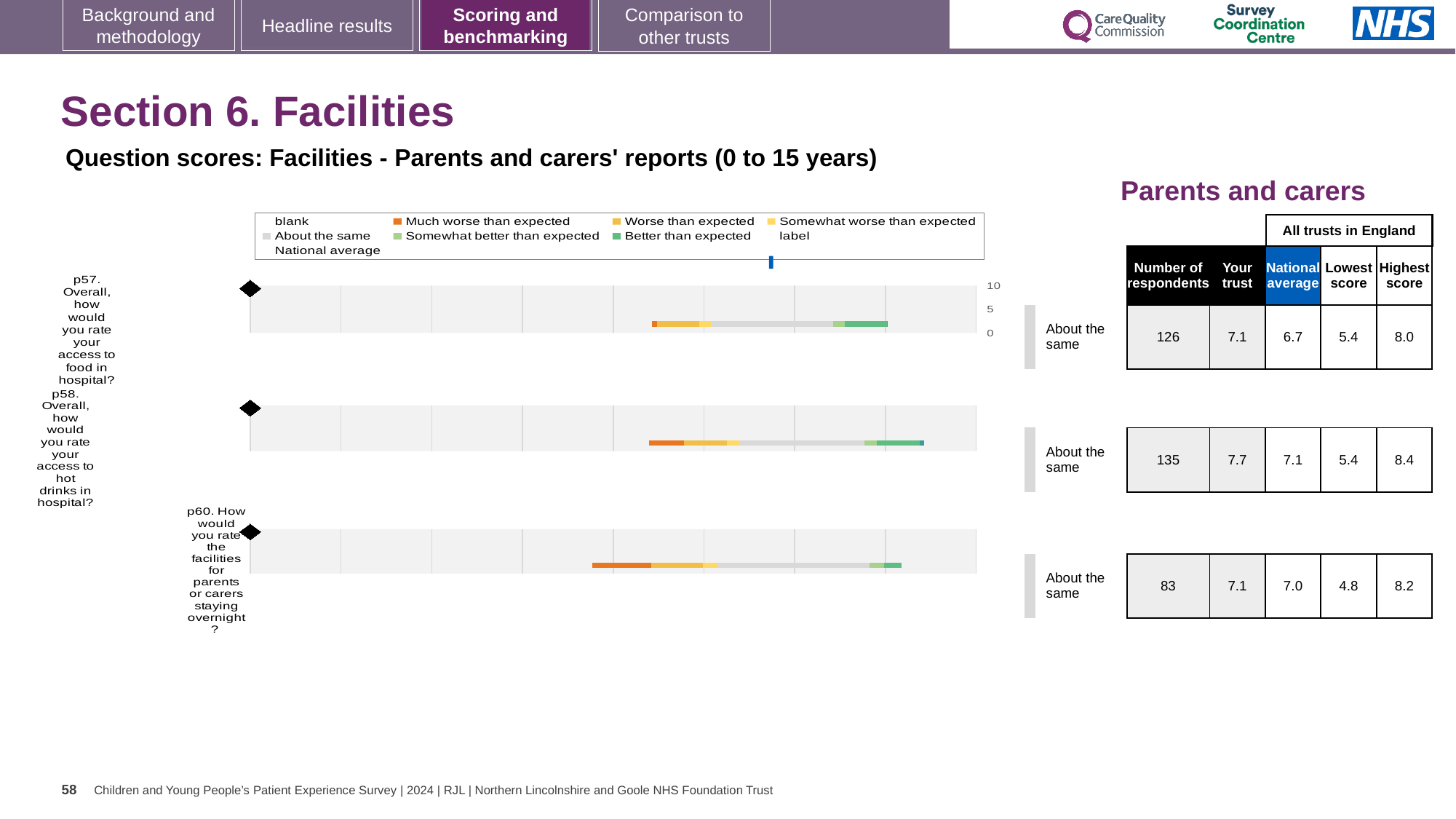
Which question has the highest 'Your trust' score? p58 What is the national average for p58? 7.1 For p58, what is the difference between the 'Your trust' score and the national average? 0.6 What is the 'Your trust' score for p57 (access to food in hospital)? 7.1 How many respondents are recorded for p58 (access to hot drinks in hospital)? 135 What benchmark category is shown for all three questions (p57, p58 and p60)? About the same How many survey questions are plotted in the benchmarking charts on this slide? 3 For p57, which is larger: the 'Your trust' score or the national average? Your trust What is the highest score across all trusts in England for p60 (facilities for parents or carers staying overnight)? 8.2 What kind of chart is used to show the benchmarking results for each question? Bar chart Which question has the lowest number of respondents? p60 Which legend entry is shown in orange? Much worse than expected